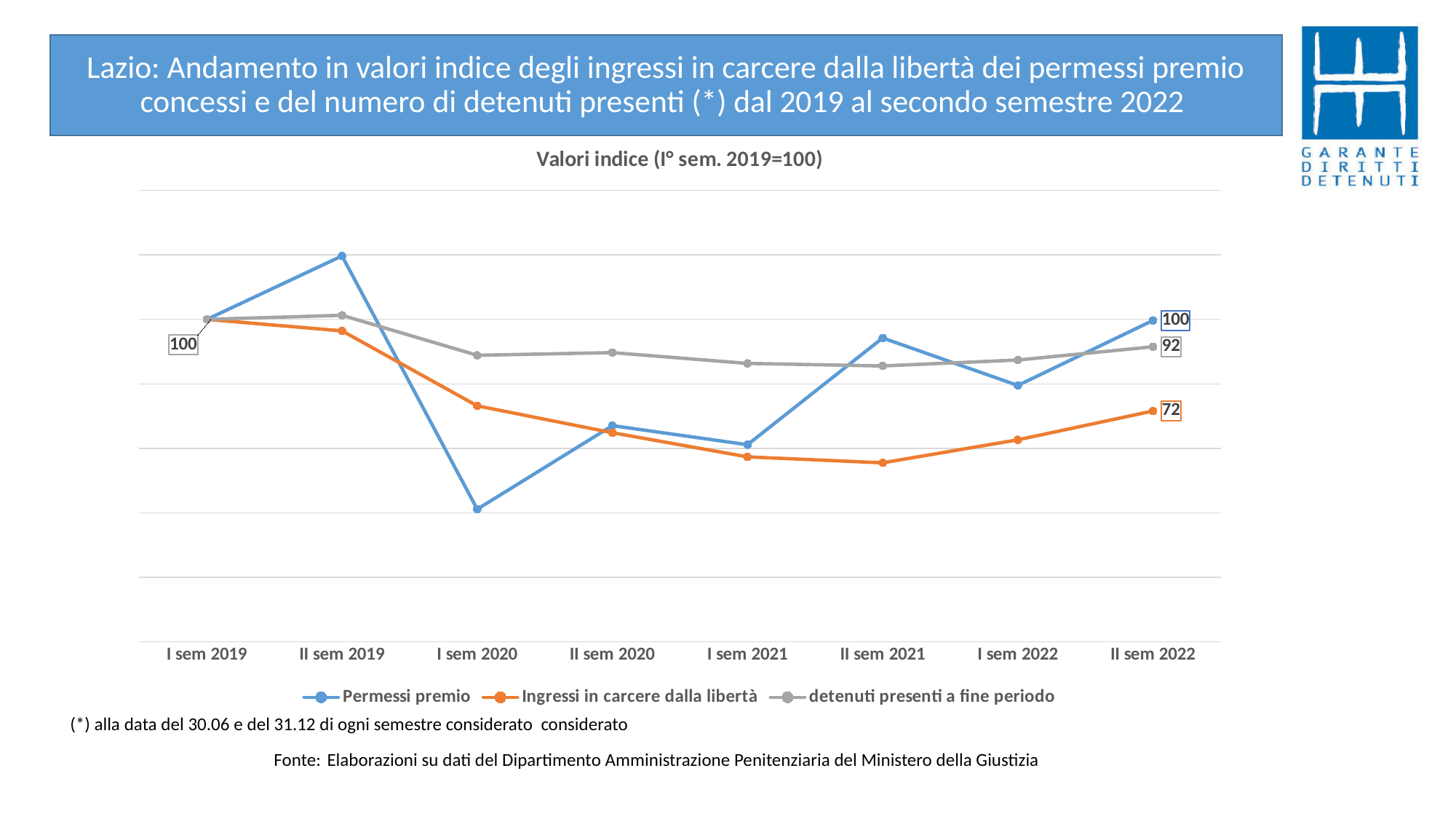
In which semester does the Permessi premio series reach its lowest value? I sem 2020 In which semester does the Permessi premio series reach its highest value? II sem 2019 What is the index value of Permessi premio in II sem 2022? 100 What kind of chart is shown on the slide? Line chart What is the difference between the detenuti presenti a fine periodo value and the Ingressi in carcere dalla libertà value in II sem 2022? 20 What is the index value of detenuti presenti a fine periodo in II sem 2022? 92 How many series does the legend list? 3 What is the difference between the Permessi premio value and the Ingressi in carcere dalla libertà value in II sem 2022? 28 What is the index value of Ingressi in carcere dalla libertà in II sem 2022? 72 What is the title printed above the chart? Valori indice (I° sem. 2019=100) In II sem 2022, which series has the higher value: Permessi premio or detenuti presenti a fine periodo? Permessi premio How many semesters are shown on the x axis? 8